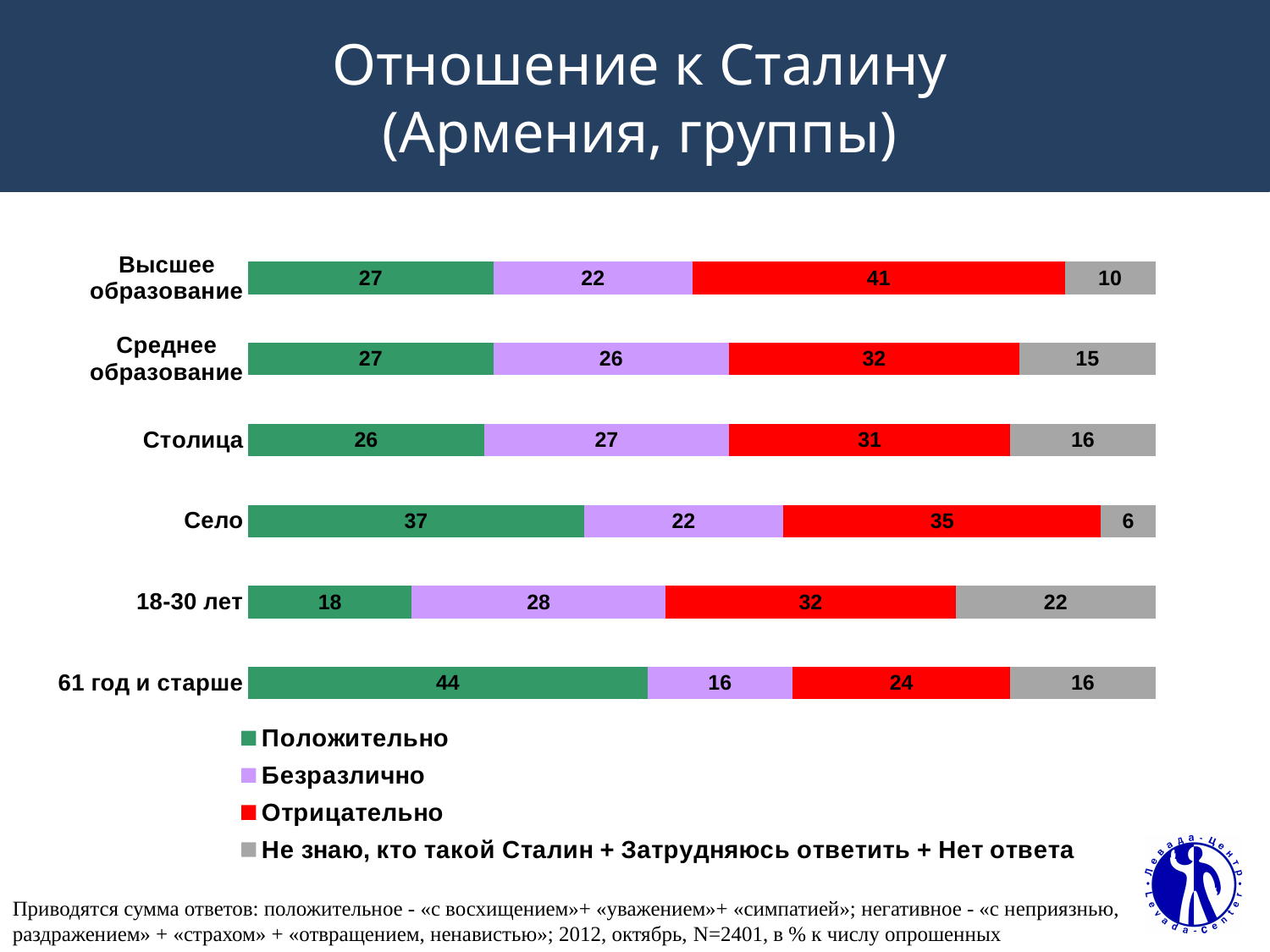
What is the difference between the "Отрицательно" values for "Высшее образование" and "61 год и старше"? 17 What is the value of "Безразлично" for "18-30 лет"? 28 How many categories (groups) are shown on the chart? 6 Which is larger: the "Положительно" value for "Село" or for "18-30 лет"? Село How many series does the legend list? 4 Which series is shown in red in the legend? Отрицательно What type of chart is shown on the slide? Stacked bar chart What is the total of the stacked bar for "Столица"? 100 What is the value of "Положительно" for "61 год и старше"? 44 Which group has the highest value for "Положительно"? 61 год и старше Which group has the lowest value for "Не знаю, кто такой Сталин + Затрудняюсь ответить + Нет ответа"? Село What is the value of "Отрицательно" for "Высшее образование"? 41